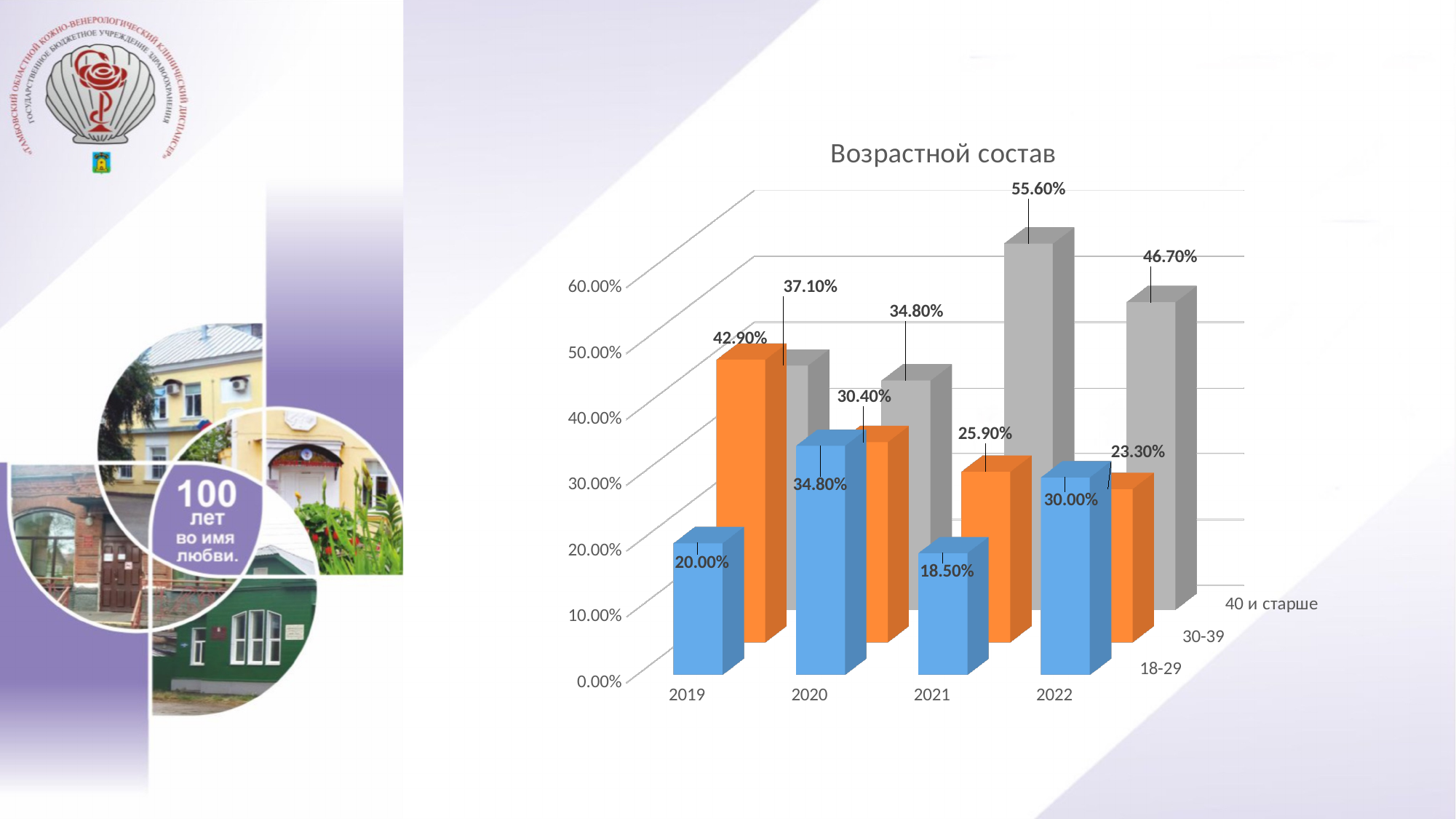
In which year is the value for the 40 и старше group highest? 2021 What is the value for the 18-29 group in 2019? 20.00% What is the title of the chart? Возрастной состав What is the value for the 30-39 group in 2019? 42.90% What is the value for the 30-39 group in 2022? 23.30% How many years are shown on the x axis? 4 In which year is the value for the 18-29 group lowest? 2021 How many age groups are plotted in the chart? 3 What is the difference between the 40 и старше value in 2021 and the 40 и старше value in 2022? 8.90% Which is larger in 2020: the 18-29 value or the 30-39 value? 18-29 What type of chart is shown on the slide? bar chart What is the value for the 40 и старше group in 2021? 55.60%